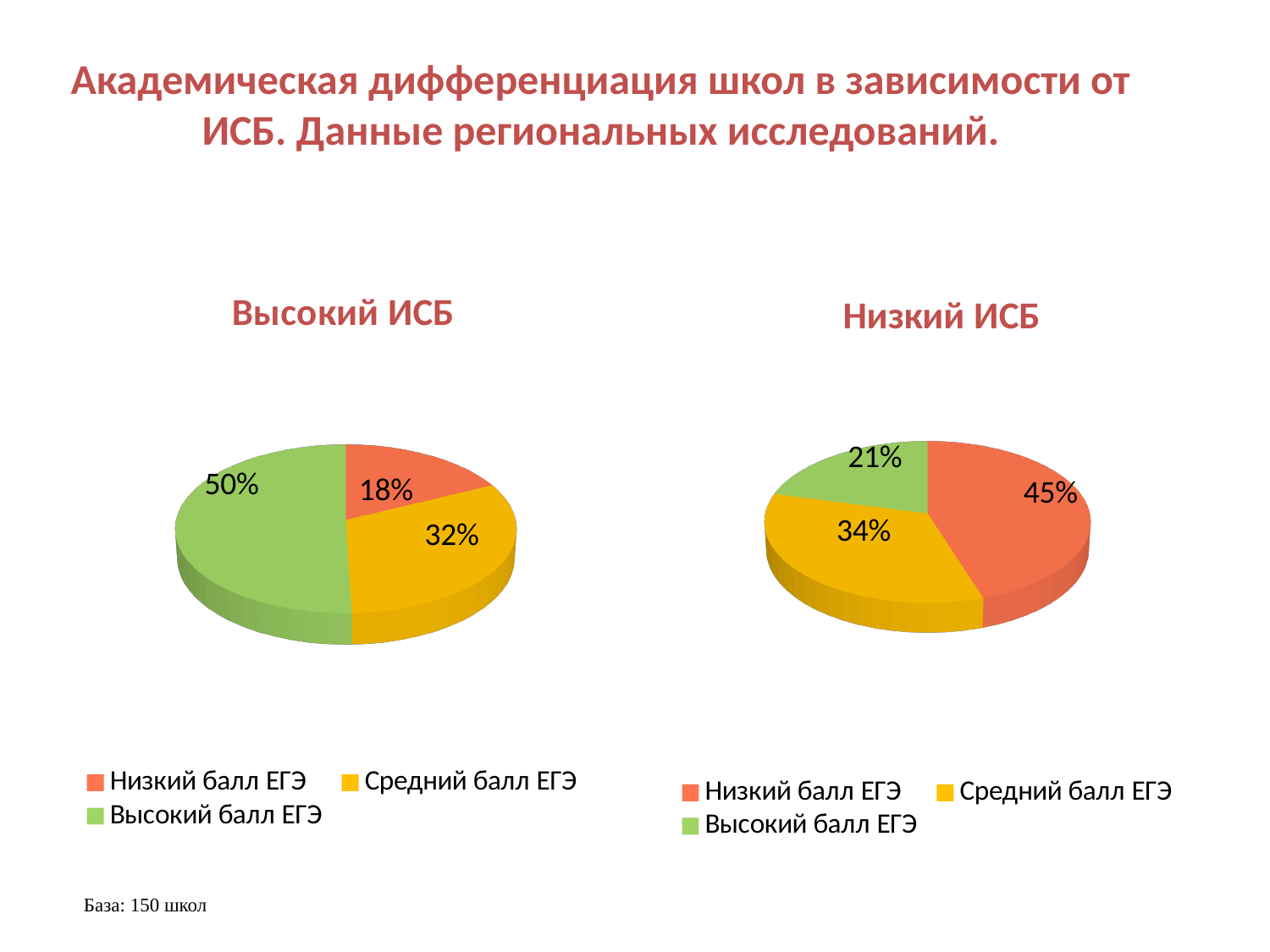
How many slices does the "Низкий ИСБ" chart have? 3 What colour represents Средний балл ЕГЭ in the legend of the "Высокий ИСБ" chart? Yellow In the "Высокий ИСБ" chart, what share is labelled for Высокий балл ЕГЭ? 50% In the "Низкий ИСБ" chart, what share is labelled for Низкий балл ЕГЭ? 45% Which is larger: the Средний балл ЕГЭ share in the "Высокий ИСБ" chart or in the "Низкий ИСБ" chart? Низкий ИСБ In the "Низкий ИСБ" chart, what is the difference between the Низкий балл ЕГЭ and Высокий балл ЕГЭ shares? 24% What type of chart is the "Высокий ИСБ" chart? Pie chart In the "Низкий ИСБ" chart, what share is labelled for Средний балл ЕГЭ? 34% In the "Высокий ИСБ" chart, which category has the largest slice? Высокий балл ЕГЭ In the "Высокий ИСБ" chart, what share is labelled for Низкий балл ЕГЭ? 18% In the "Высокий ИСБ" chart, what is the difference between the Высокий балл ЕГЭ and Низкий балл ЕГЭ shares? 32% In the "Низкий ИСБ" chart, which category has the smallest slice? Высокий балл ЕГЭ